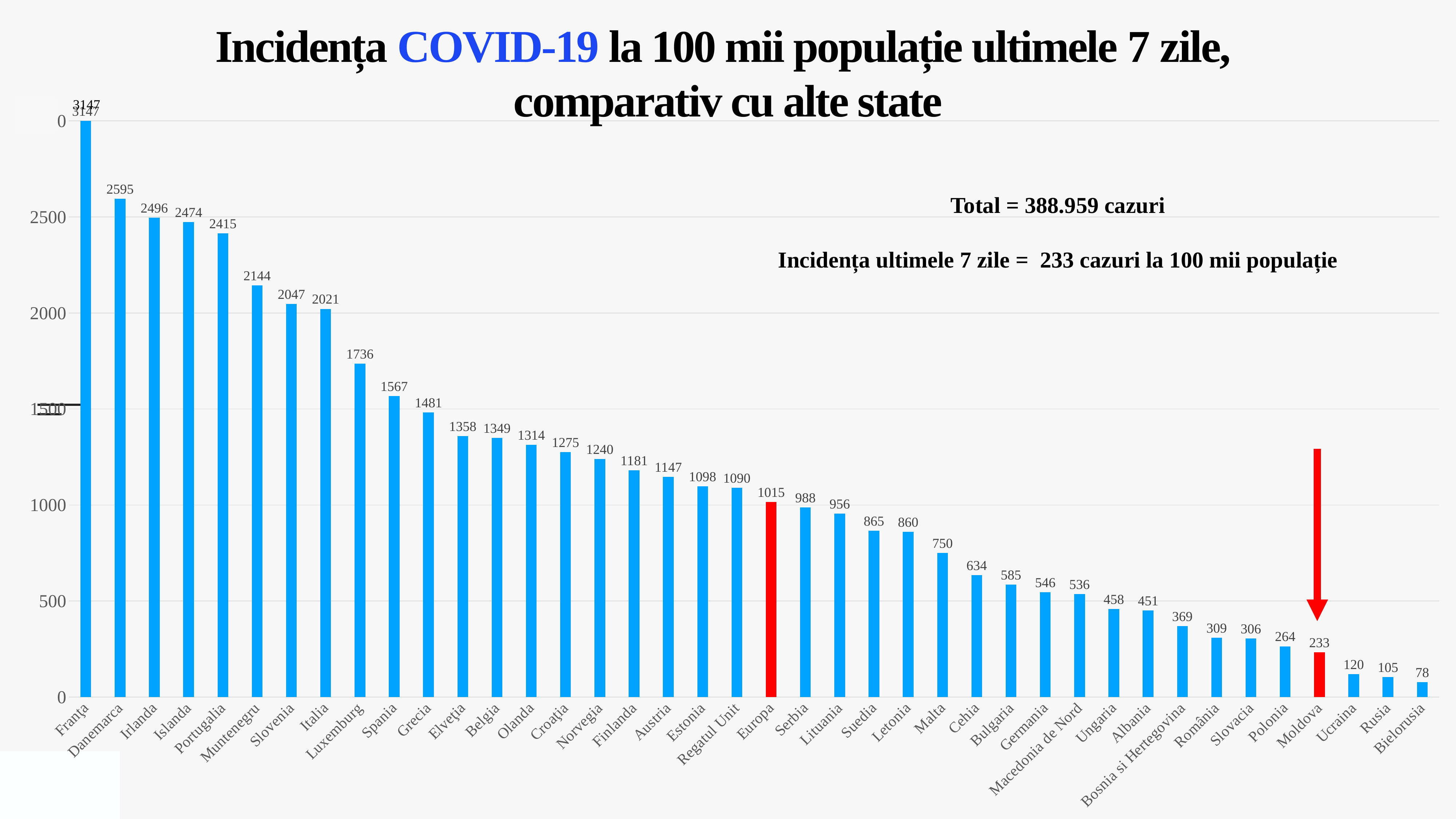
Which country has the lowest value? Bielorusia What is the difference between the values for Franța and Danemarca? 552 Which has a larger value, Italia or Spania? Italia What is the difference between the values for Europa and Moldova? 782 Which has a larger value, Ucraina or Polonia? Polonia What is the value for Europa? 1015 What is the value for Moldova? 233 Which country has the highest value? Franța Which bars are coloured red instead of blue? Europa and Moldova What is the value for România? 309 How many countries/regions are shown on the x axis? 40 What kind of chart is shown on the slide? Bar chart